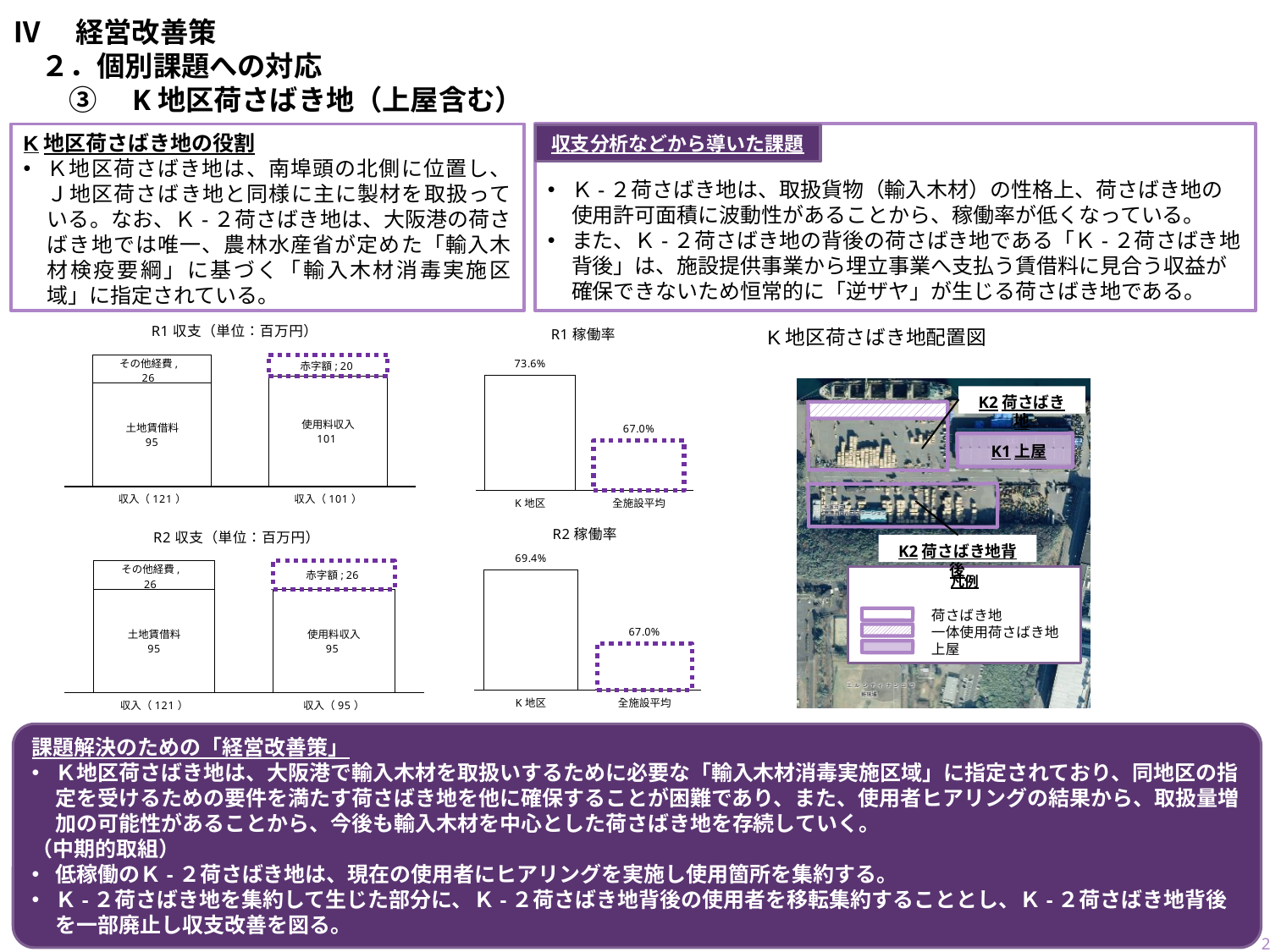
「R1 稼働率」のグラフはどの種類のグラフですか。 棒グラフ 「R2 収支」のグラフで、土地賃借料とその他経費の合計はいくらですか。 121 「R1 収支」のグラフの単位は何ですか。 百万円 「R2 稼働率」のグラフで、K地区の値はいくらですか。 69.4% 「R1 収支」のグラフで、使用料収入の値はいくらですか。 101 「R1 稼働率」のグラフで、K地区と全施設平均ではどちらが高いですか。 K地区 「R1 収支」のグラフで、赤字額はいくらですか。 20 「R2 稼働率」のグラフで、K地区と全施設平均の差はいくらですか。 2.4% 「R1 稼働率」のグラフで、全施設平均の値はいくらですか。 67.0% 「R1 稼働率」のグラフで、K地区の値はいくらですか。 73.6% 「R2 収支」のグラフで、土地賃借料の値はいくらですか。 95 「R2 収支」のグラフで、赤字額はいくらですか。 26